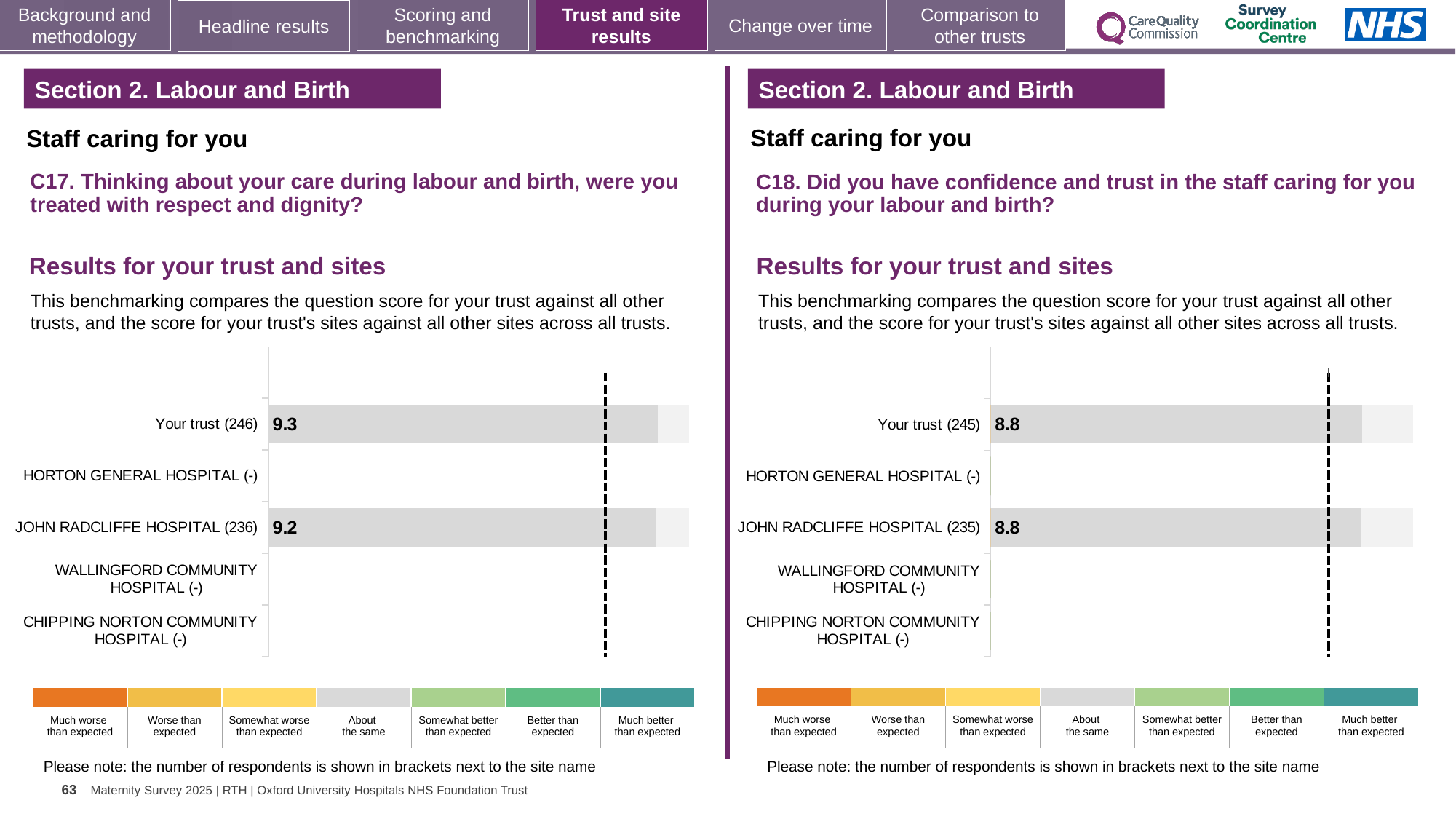
In the C18 chart on the right, how many respondents are shown in brackets for Your trust? 245 In the C17 chart on the left, which has the higher score, Your trust or JOHN RADCLIFFE HOSPITAL? Your trust In the C17 chart on the left, which site has no score shown and is marked with (-) alongside HORTON GENERAL HOSPITAL and WALLINGFORD COMMUNITY HOSPITAL? CHIPPING NORTON COMMUNITY HOSPITAL In the C18 chart on the right, what is the score for Your trust? 8.8 In the C18 chart on the right, how many categories in the colour key below the chart? 7 In the C17 chart on the left, how many respondents are shown in brackets for JOHN RADCLIFFE HOSPITAL? 236 What kind of chart is used in the C18 chart on the right? Bar chart In the C17 chart on the left, what is the difference between the score for Your trust and the score for JOHN RADCLIFFE HOSPITAL? 0.1 In the C17 chart on the left, what is the score for Your trust? 9.3 In the C17 chart on the left, how many site or trust categories are listed on the vertical axis? 5 In the C17 chart on the left, what is the score for JOHN RADCLIFFE HOSPITAL? 9.2 In the C18 chart on the right, what is the score for JOHN RADCLIFFE HOSPITAL? 8.8